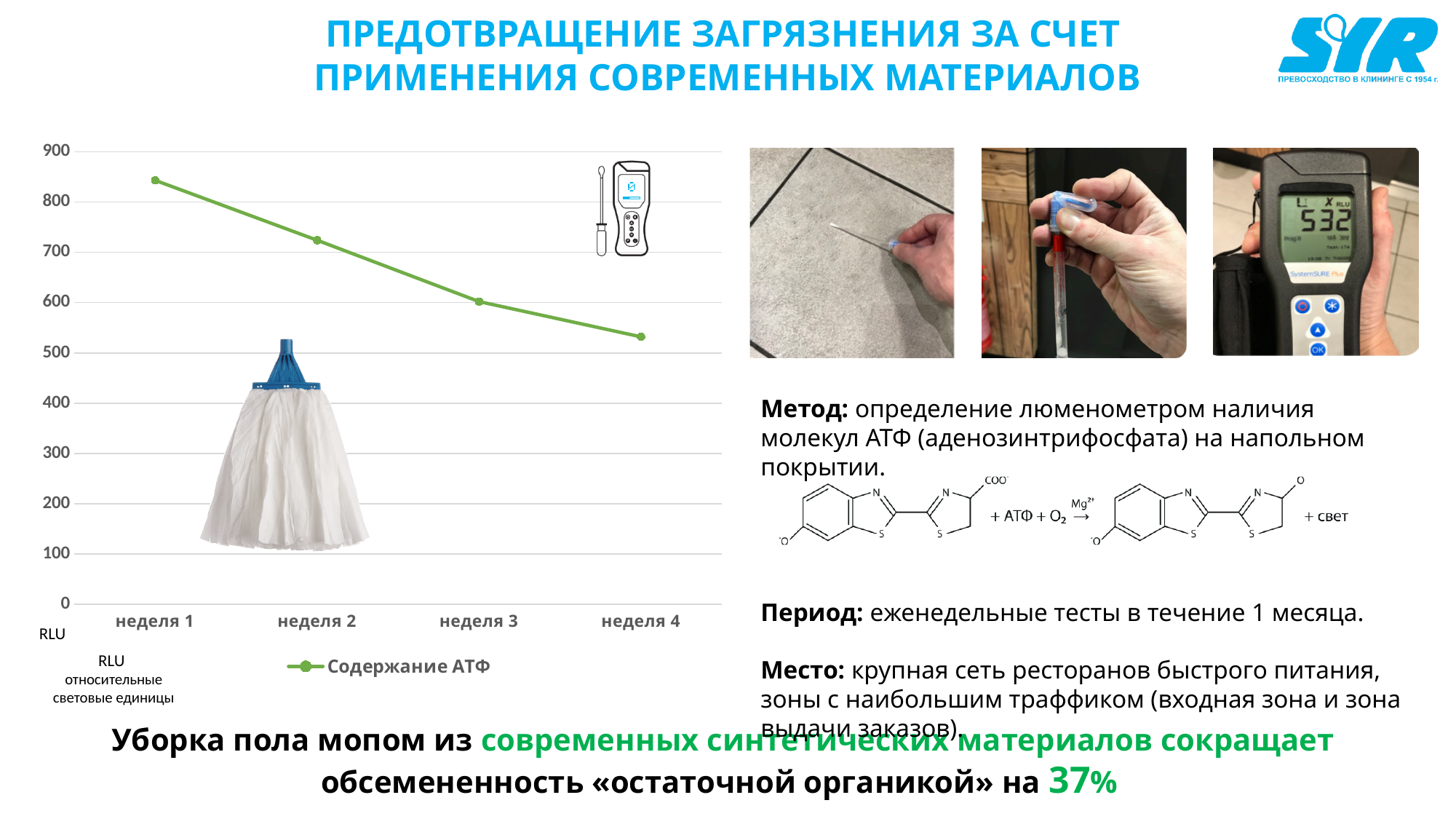
Which week has the highest value on the chart? неделя 1 Is the value for неделя 4 greater or less than 600? less Is the value for неделя 1 greater or less than 800? greater Do the values rise or fall from неделя 1 to неделя 4? fall What unit is indicated for the vertical axis of the chart? RLU Which is larger, the value for неделя 2 or the value for неделя 3? неделя 2 Which week has the lowest value on the chart? неделя 4 How many weeks (data points) are plotted on the chart? 4 How many series does the chart legend list? 1 What is the name of the series shown in the chart legend? Содержание АТФ Is the value for неделя 2 greater or less than 700? greater What kind of chart is shown on the left of the slide? line chart